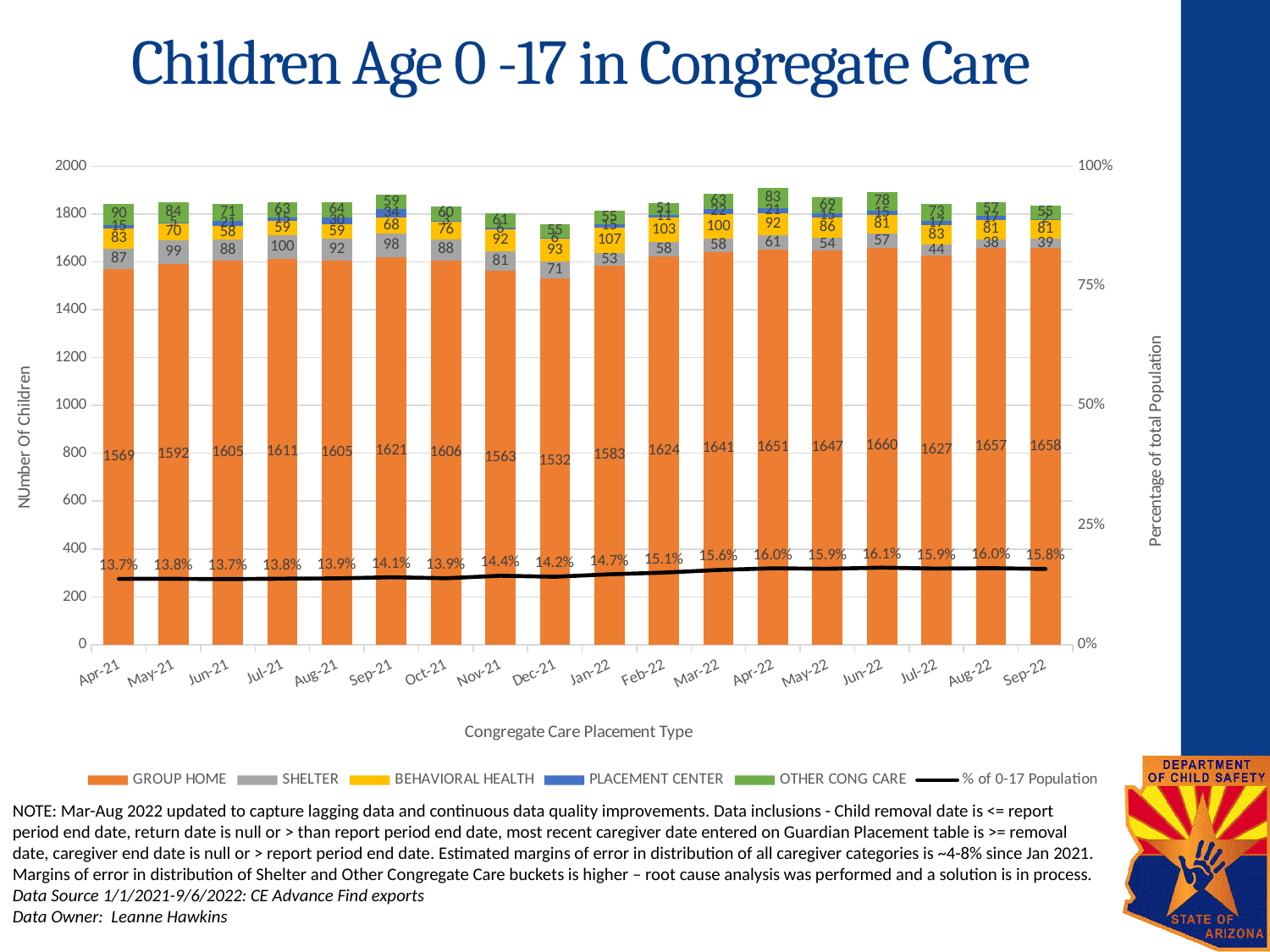
How many series does the legend list? 6 What is the BEHAVIORAL HEALTH value for Jan-22? 107 Which month has the lowest GROUP HOME value? Dec-21 What is the % of 0-17 Population value for Jun-22? 16.1% Which month has the highest GROUP HOME value? Jun-22 What is the GROUP HOME value for Sep-22? 1658 Which is larger, the SHELTER value for Apr-21 or for Aug-22? Apr-21 Does the % of 0-17 Population line generally rise or fall from Apr-21 to Sep-22? rise Which month has the lowest SHELTER value? Aug-22 What is the difference between the GROUP HOME values for Sep-22 and Apr-21? 89 How many months are shown on the x axis? 18 What is the SHELTER value for Apr-21? 87